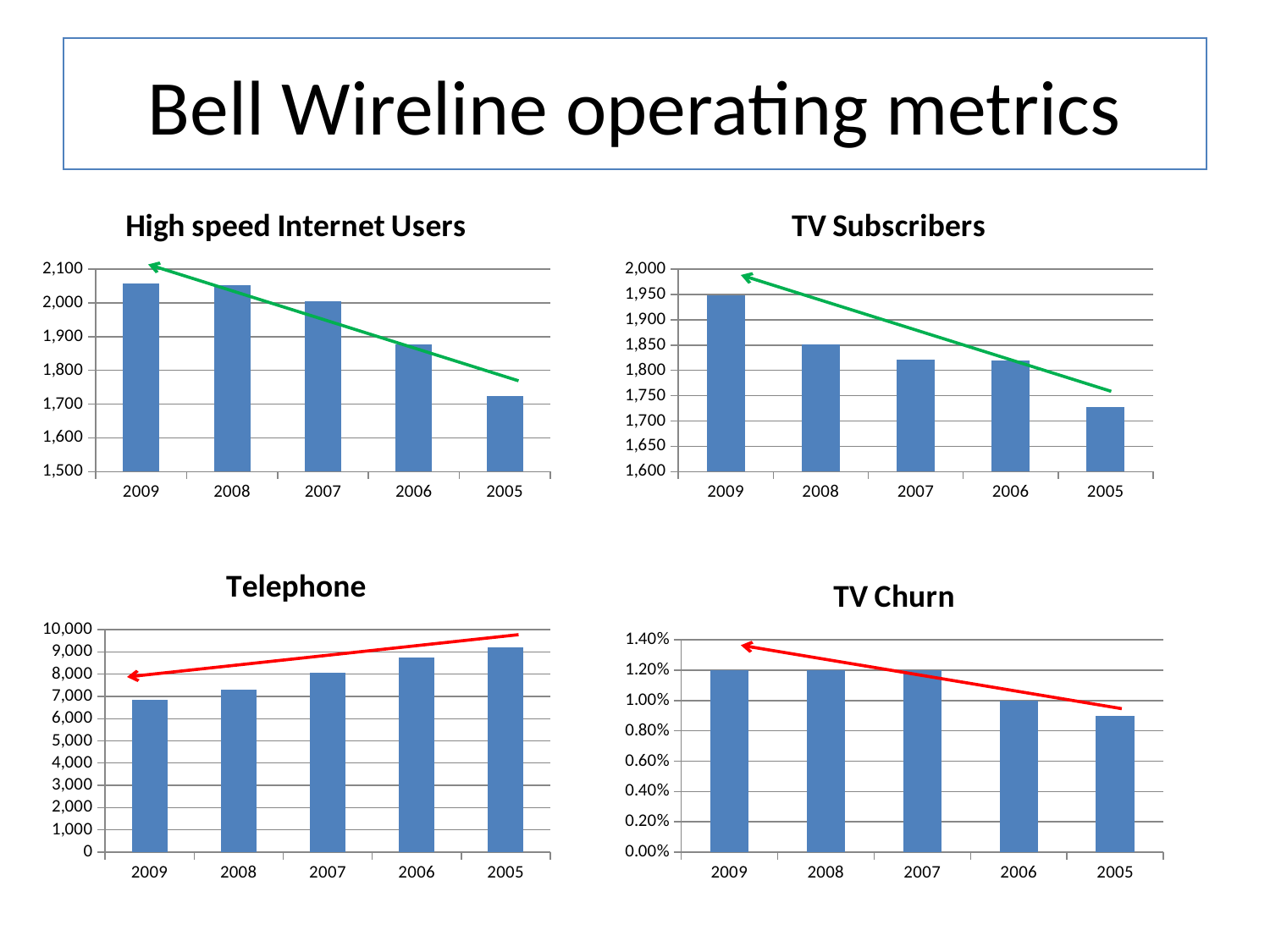
In the TV Subscribers chart, is the value for 2005 greater or less than 1,750? less In the High speed Internet Users chart, is the value for 2005 greater or less than 1,800? less In the TV Subscribers chart, do the values rise or fall moving left to right along the x axis from 2009 to 2005? fall In the Telephone chart, which year has the highest value? 2005 In the Telephone chart, which year has the lowest value? 2009 What kind of chart is the High speed Internet Users chart? bar chart How many years are shown on the x axis of the TV Subscribers chart? 5 In the High speed Internet Users chart, which year has the highest value? 2009 In the Telephone chart, is the value for 2009 greater or less than 7,000? less In the Telephone chart, do the values rise or fall moving left to right along the x axis from 2009 to 2005? rise In the TV Churn chart, what is the value for 2006? 1.00% In the TV Churn chart, which is larger, the value for 2009 or the value for 2005? 2009